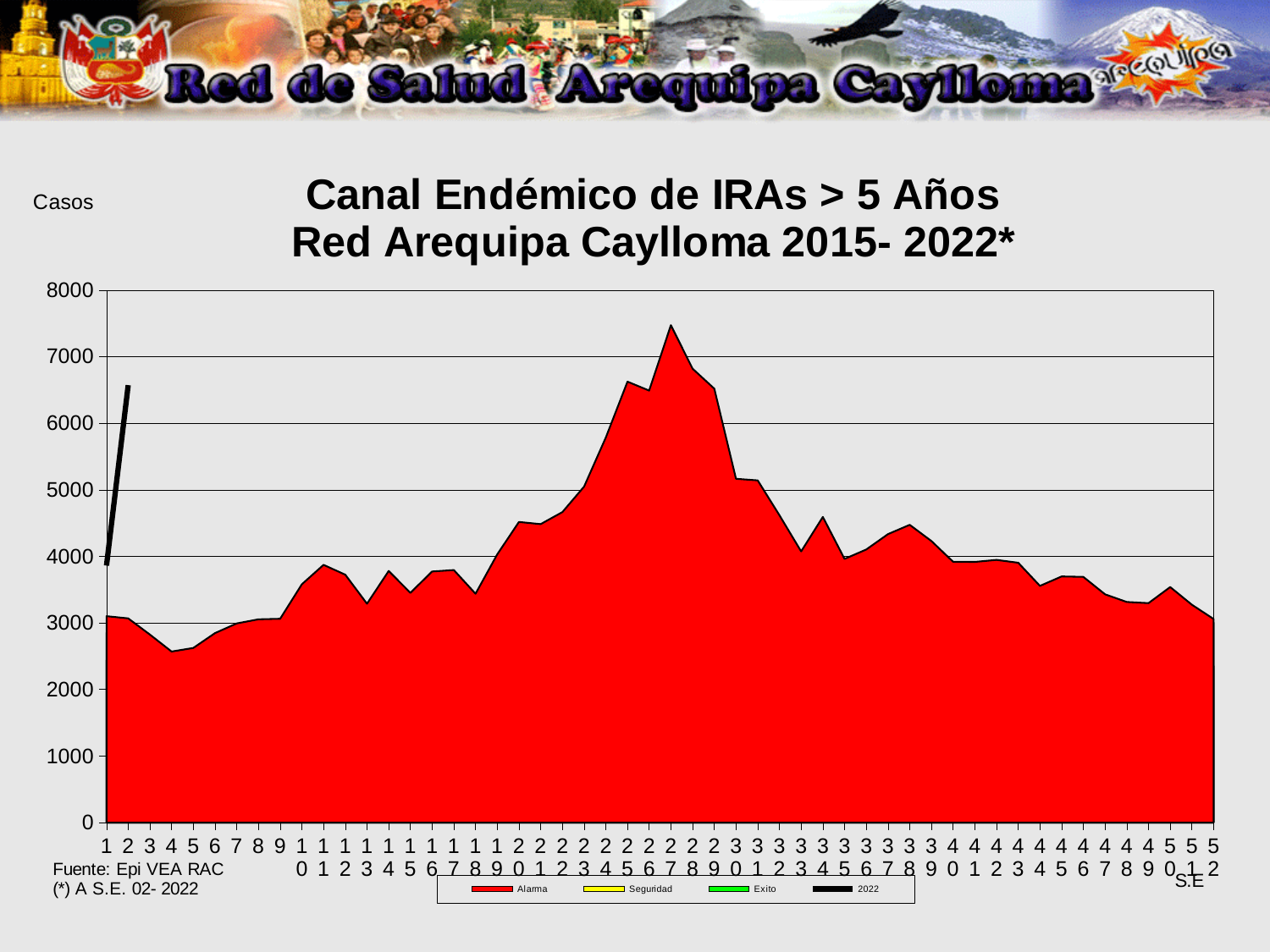
Do the Alarma values rise or fall from week 27 to week 35? fall Is the 2022 value at week 2 greater or less than 6000? greater How many epidemiological weeks (S.E.) are shown along the x axis? 52 What is the title of the chart? Canal Endémico de IRAs > 5 Años Red Arequipa Caylloma 2015- 2022* Is the Alarma value at week 52 greater or less than 4000? less Is the Alarma value at week 4 greater or less than 3000? less Which has the larger Alarma value, week 27 or week 4? week 27 At which week does the Alarma series reach its highest value? 27 What kind of chart is shown on the slide? area chart Do the Alarma values rise or fall from week 20 to week 27? rise How many series does the legend list? 4